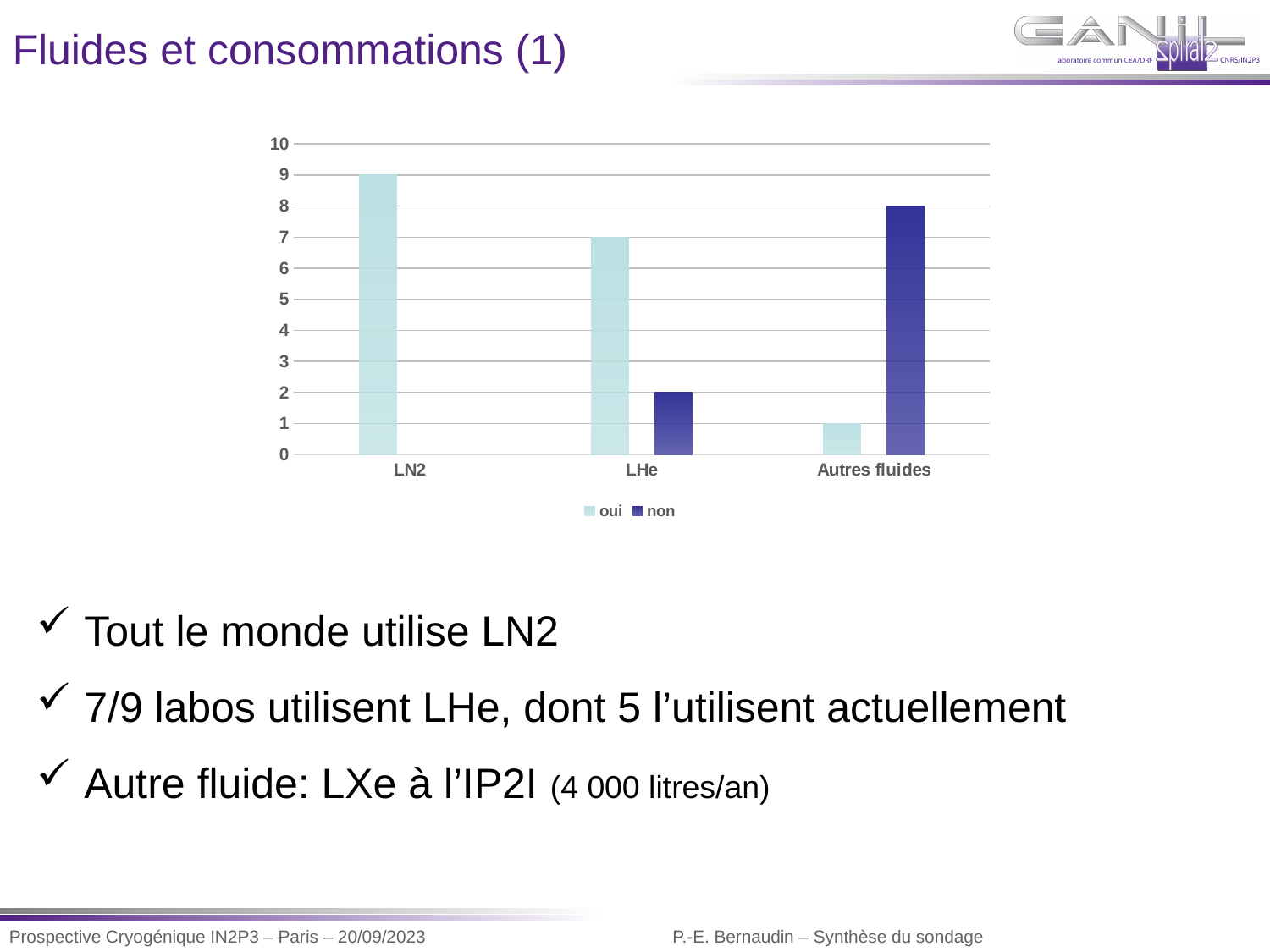
What are the two series named in the chart's legend? oui and non What kind of chart is shown on the slide? bar chart Which category has the highest 'oui' value? LN2 How many series does the chart's legend list? 2 What is the value of the 'oui' bar for LHe? 7 For Autres fluides, which is larger, the 'oui' value or the 'non' value? non What is the value of the 'oui' bar for LN2? 9 Which category has the lowest 'oui' value? Autres fluides What is the value of the 'non' bar for Autres fluides? 8 How many categories are shown on the x axis of the chart? 3 What is the difference between the 'oui' and 'non' values for LHe? 5 What is the value of the 'non' bar for LHe? 2